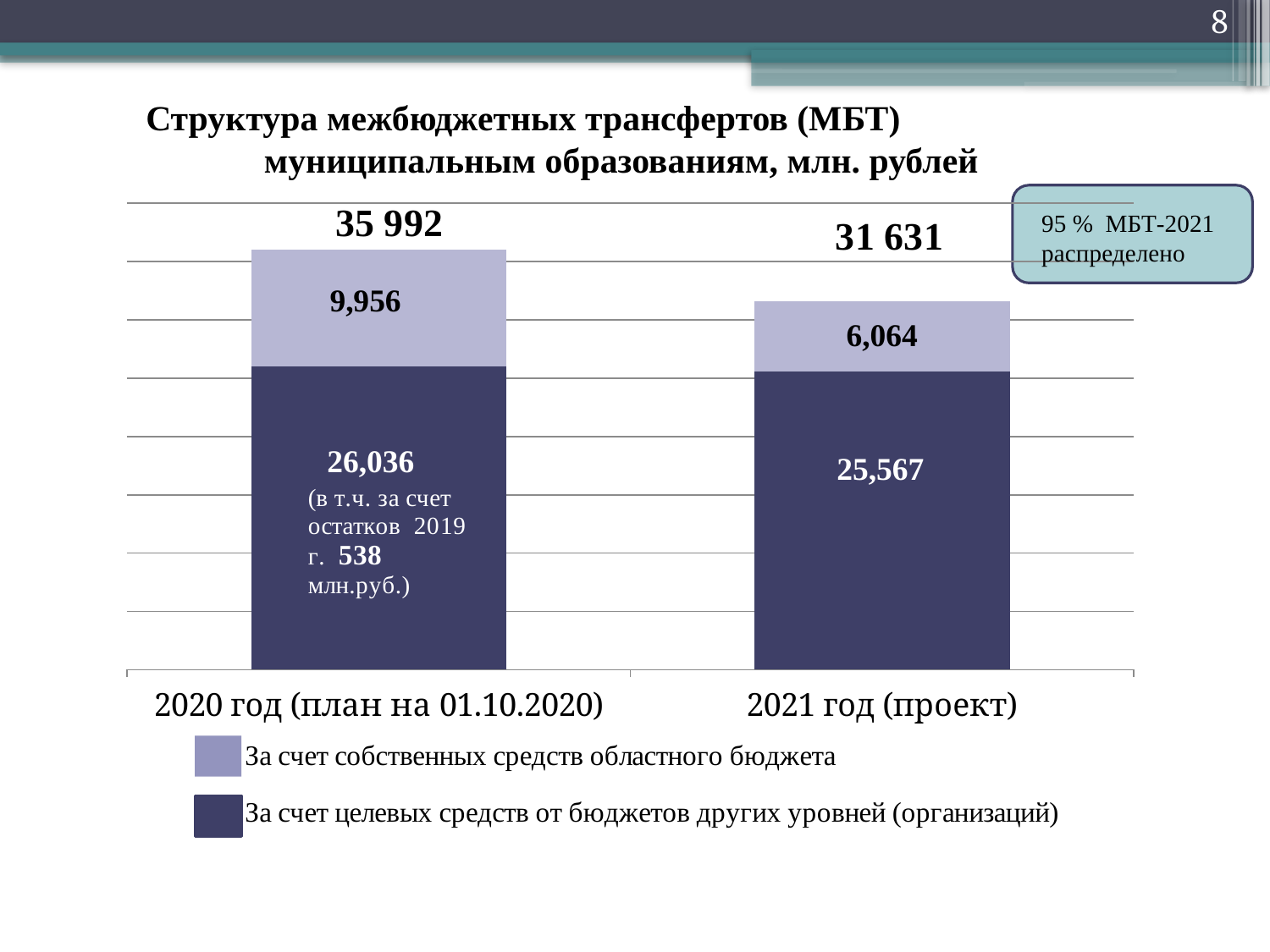
What is the difference between the 'За счет целевых средств от бюджетов других уровней (организаций)' values for 2020 and 2021? 469 How many categories are shown on the x axis? 2 What is the difference between the 'За счет собственных средств областного бюджета' values for 2020 and 2021? 3,892 What type of chart is shown on the slide? stacked bar chart Is the 'За счет целевых средств' value larger in 2020 or in 2021? 2020 What is the total of the stacked bar for 2021 год (проект)? 31 631 What is the value for 'За счет целевых средств от бюджетов других уровней (организаций)' in 2021 год (проект)? 25,567 How many series does the legend list? 2 Which year has the higher total of interbudget transfers? 2020 год (план на 01.10.2020) What is the value for 'За счет собственных средств областного бюджета' in 2020 год (план на 01.10.2020)? 9,956 What is the value for 'За счет собственных средств областного бюджета' in 2021 год (проект)? 6,064 What is the total of the stacked bar for 2020 год (план на 01.10.2020)? 35 992